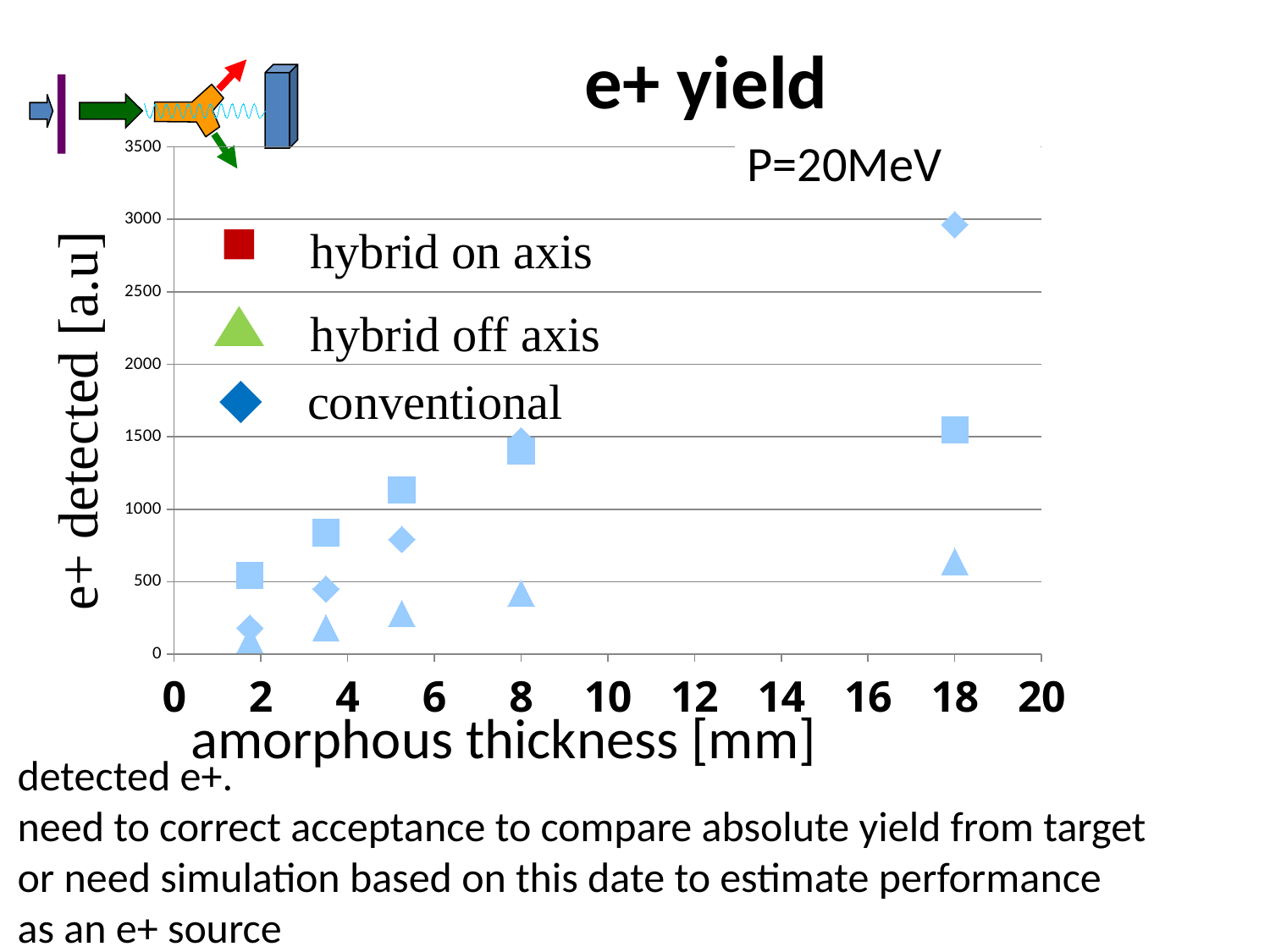
Is the value for hybrid on axis at 8 mm greater or less than 1000? greater Is the value for hybrid off axis at 18 mm greater or less than 1000? less Is the value for hybrid on axis at 18 mm greater or less than 2000? less At 18 mm, which series has the lowest e+ detected value? hybrid off axis How many data points are plotted for the conventional series? 5 At 18 mm, which series has the highest e+ detected value? conventional What kind of chart is shown on the slide? scatter chart How many series does the legend list? 3 What is the title of the chart? e+ yield What is the label of the x axis? amorphous thickness [mm] Do the values for the hybrid on axis series rise or fall as amorphous thickness increases? rise